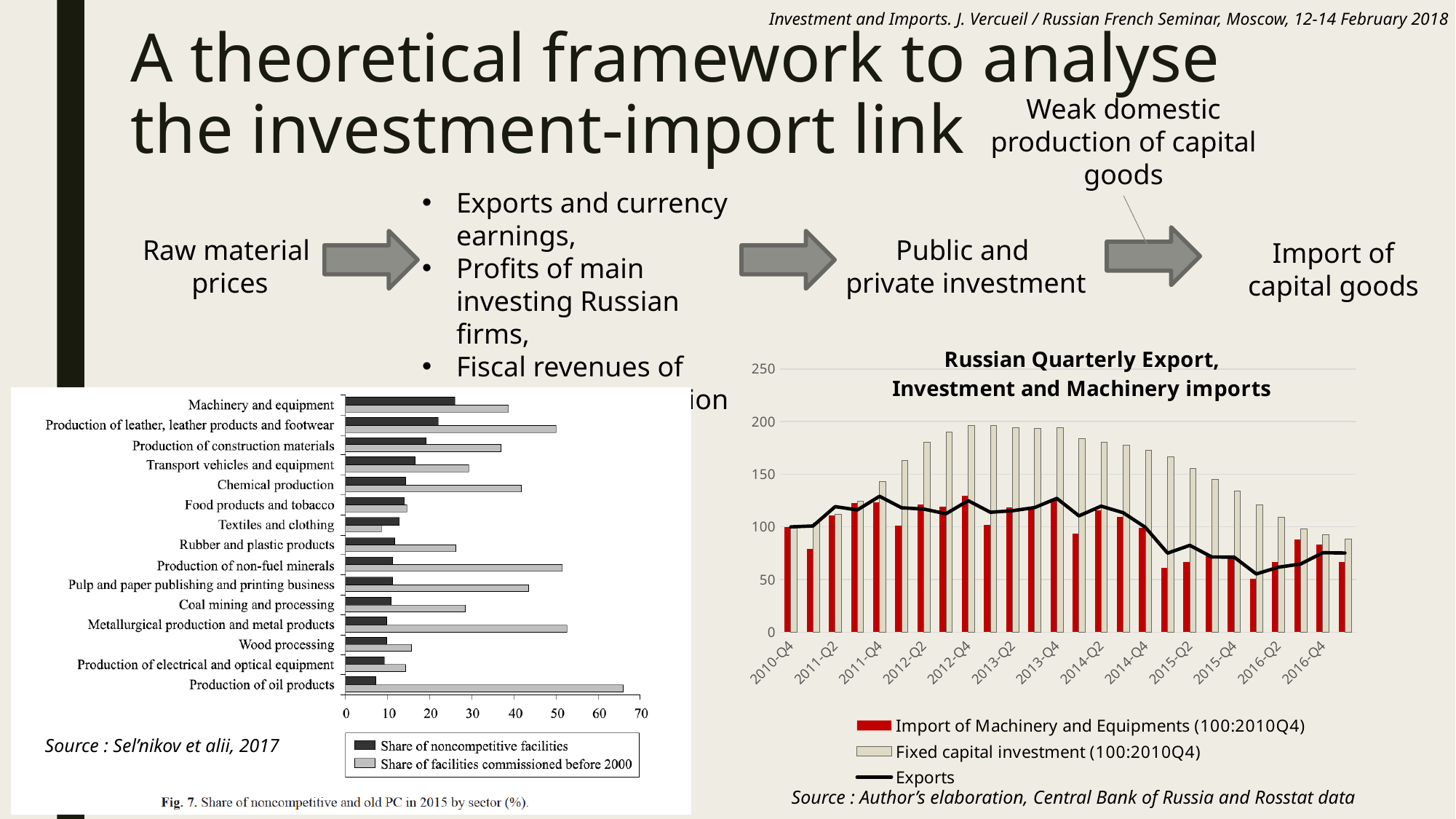
What kind of chart is the left chart (Fig. 7)? bar chart In the left chart (Fig. 7), which sector has the highest share of noncompetitive facilities? Machinery and equipment In the left chart (Fig. 7), which sector has the highest share of facilities commissioned before 2000? Production of oil products In the left chart (Fig. 7), which is larger for Chemical production: the share of noncompetitive facilities or the share of facilities commissioned before 2000? Share of facilities commissioned before 2000 How many sectors are listed in the left chart (Fig. 7)? 15 In the right chart 'Russian Quarterly Export, Investment and Machinery imports', does Fixed capital investment rise or fall from 2013-Q4 to 2016-Q4? fall In the right chart 'Russian Quarterly Export, Investment and Machinery imports', is the Fixed capital investment value at 2012-Q4 greater or less than 150? greater How many series does the legend of the left chart (Fig. 7) list? 2 In the right chart 'Russian Quarterly Export, Investment and Machinery imports', what is the value of Import of Machinery and Equipments at 2010-Q4? 100 In the left chart (Fig. 7), is the share of noncompetitive facilities for Machinery and equipment greater or less than 20? greater How many series does the legend of the right chart 'Russian Quarterly Export, Investment and Machinery imports' list? 3 In the left chart (Fig. 7), is the share of facilities commissioned before 2000 for Production of oil products greater or less than 60? greater